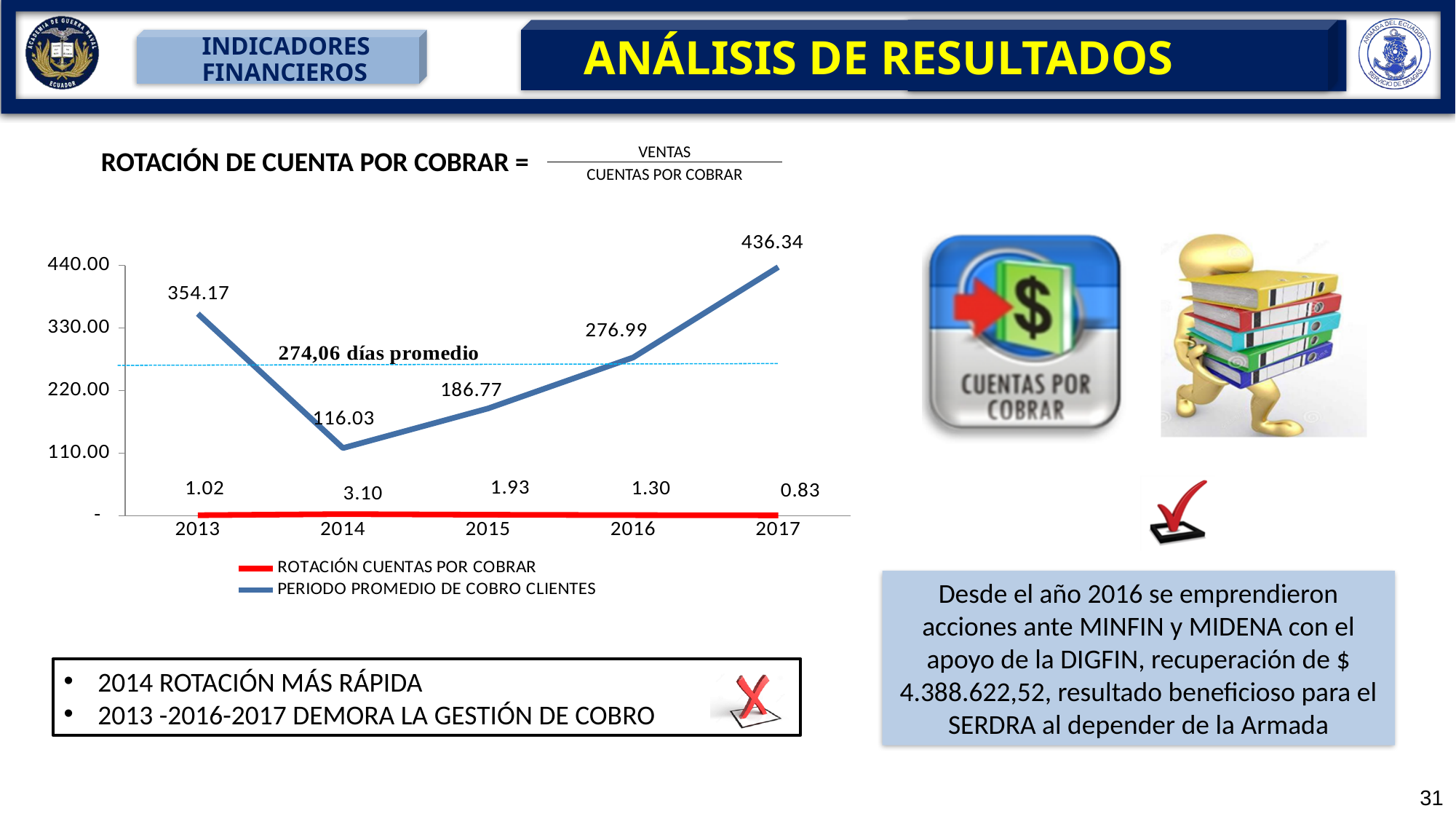
What is the value of ROTACIÓN CUENTAS POR COBRAR in 2014? 3.10 Does PERIODO PROMEDIO DE COBRO CLIENTES rise or fall from 2014 to 2017? rise In which year is ROTACIÓN CUENTAS POR COBRAR highest? 2014 What is the difference between the PERIODO PROMEDIO DE COBRO CLIENTES values for 2017 and 2016? 159.35 What average value is labelled on the dashed horizontal line in the chart? 274,06 días promedio Which year has a larger ROTACIÓN CUENTAS POR COBRAR value, 2015 or 2017? 2015 In which year is PERIODO PROMEDIO DE COBRO CLIENTES lowest? 2014 What is the value of PERIODO PROMEDIO DE COBRO CLIENTES in 2017? 436.34 How many series does the chart legend list? 2 What kind of chart is shown on the slide? line chart What is the value of PERIODO PROMEDIO DE COBRO CLIENTES in 2013? 354.17 How many years are plotted on the x axis of the chart? 5